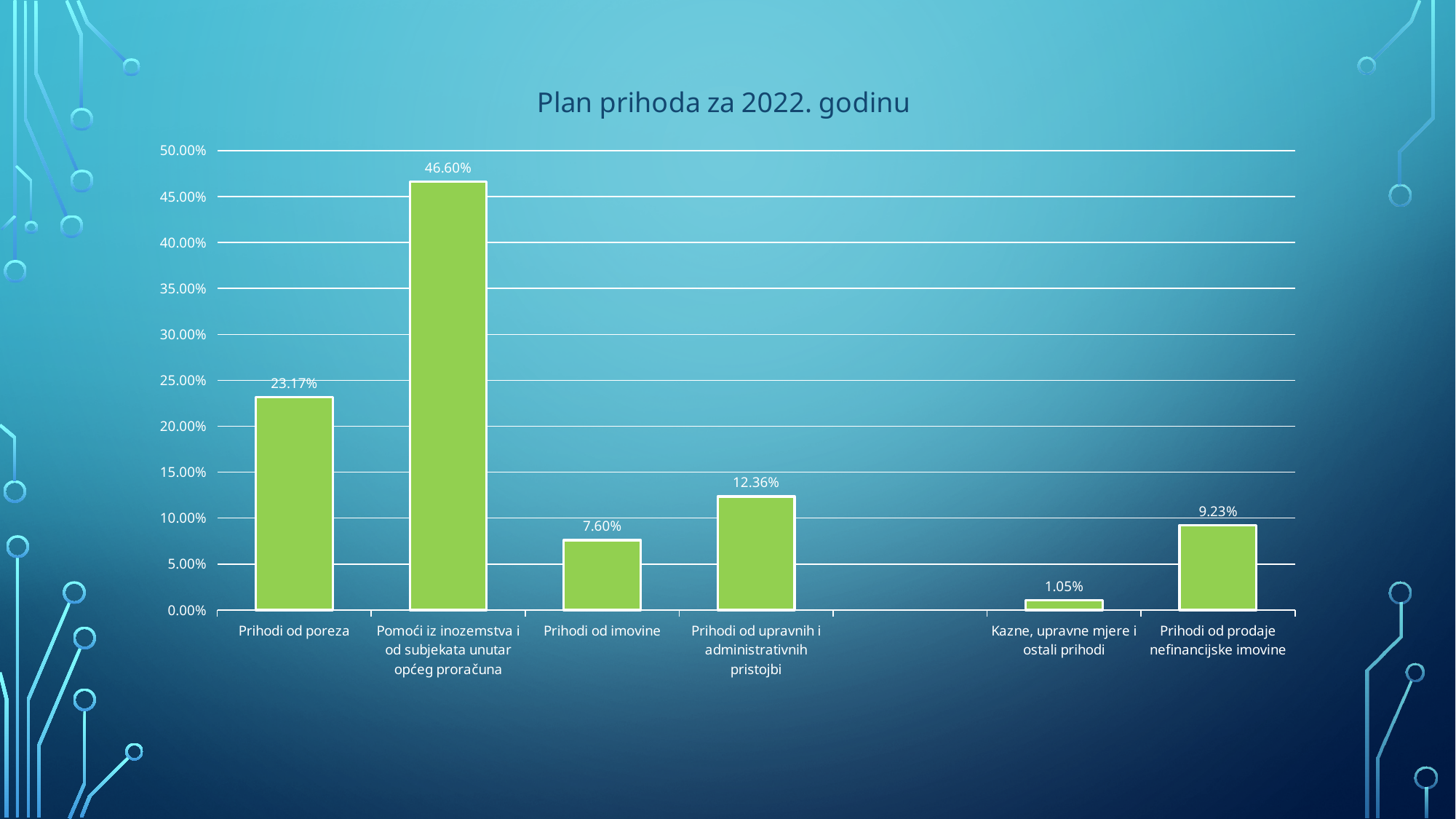
How many bars are shown in the chart? 6 What is the value for Pomoći iz inozemstva i od subjekata unutar općeg proračuna? 46.60% What is the title of the chart? Plan prihoda za 2022. godinu What is the difference between the values for Pomoći iz inozemstva i od subjekata unutar općeg proračuna and Prihodi od poreza? 23.43% Which category has the highest value? Pomoći iz inozemstva i od subjekata unutar općeg proračuna What is the value for Prihodi od imovine? 7.60% What is the difference between the values for Prihodi od upravnih i administrativnih pristojbi and Prihodi od imovine? 4.76% What is the value for Prihodi od poreza? 23.17% Which category has the lowest value? Kazne, upravne mjere i ostali prihodi Is the value for Prihodi od poreza greater or less than 25.00%? less What is the value for Prihodi od prodaje nefinancijske imovine? 9.23% Which is larger, the value for Prihodi od prodaje nefinancijske imovine or the value for Prihodi od imovine? Prihodi od prodaje nefinancijske imovine